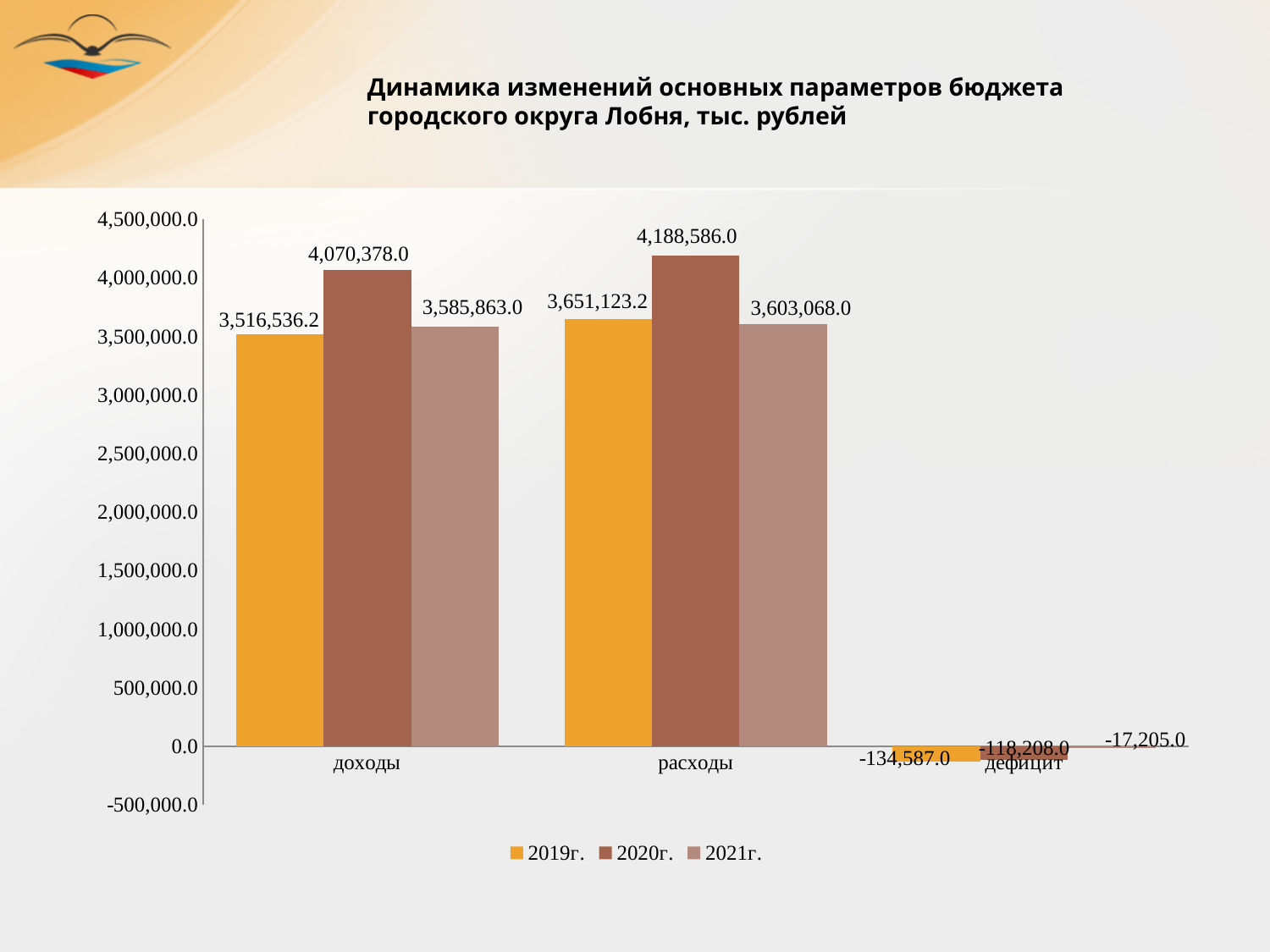
What is the difference between расходы and доходы in 2020г.? 118,208.0 How many categories are shown on the x axis? 3 What is the value for доходы in 2020г.? 4,070,378.0 How many series does the legend list? 3 What is the value for доходы in 2021г.? 3,585,863.0 What kind of chart is shown on the slide? bar chart Which year has the lowest value for доходы? 2019г. What is the title of the chart? Динамика изменений основных параметров бюджета городского округа Лобня, тыс. рублей What is the value for дефицит in 2021г.? -17,205.0 Which year has the highest value for расходы? 2020г. What is the value for расходы in 2019г.? 3,651,123.2 Which is larger: доходы in 2021г. or доходы in 2019г.? доходы in 2021г.